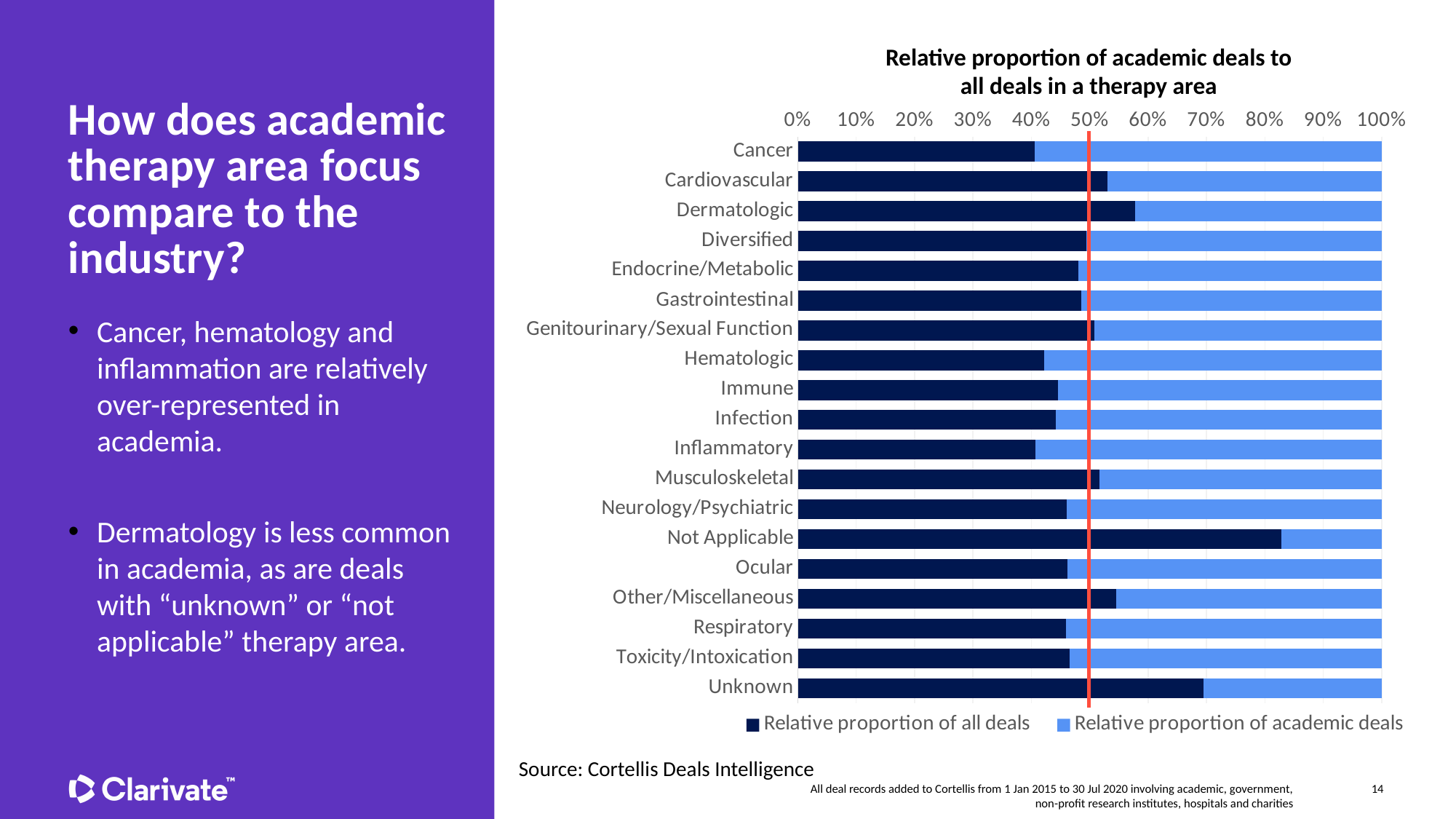
Is the 'Relative proportion of all deals' value for Cancer greater or less than 50%? less How many series does the chart legend list? 2 Is the 'Relative proportion of all deals' value for Unknown greater or less than 60%? greater Which therapy area has the largest 'Relative proportion of all deals' segment? Not Applicable Which has a larger 'Relative proportion of all deals' segment, Not Applicable or Unknown? Not Applicable At what axis value is the vertical red reference line drawn on the chart? 50% What kind of chart is shown on the slide? bar chart Is the 'Relative proportion of all deals' value for Hematologic greater or less than 50%? less What is the title of the chart? Relative proportion of academic deals to all deals in a therapy area How many therapy area categories are plotted in the chart? 19 Which has a larger 'Relative proportion of all deals' segment, Dermatologic or Cancer? Dermatologic